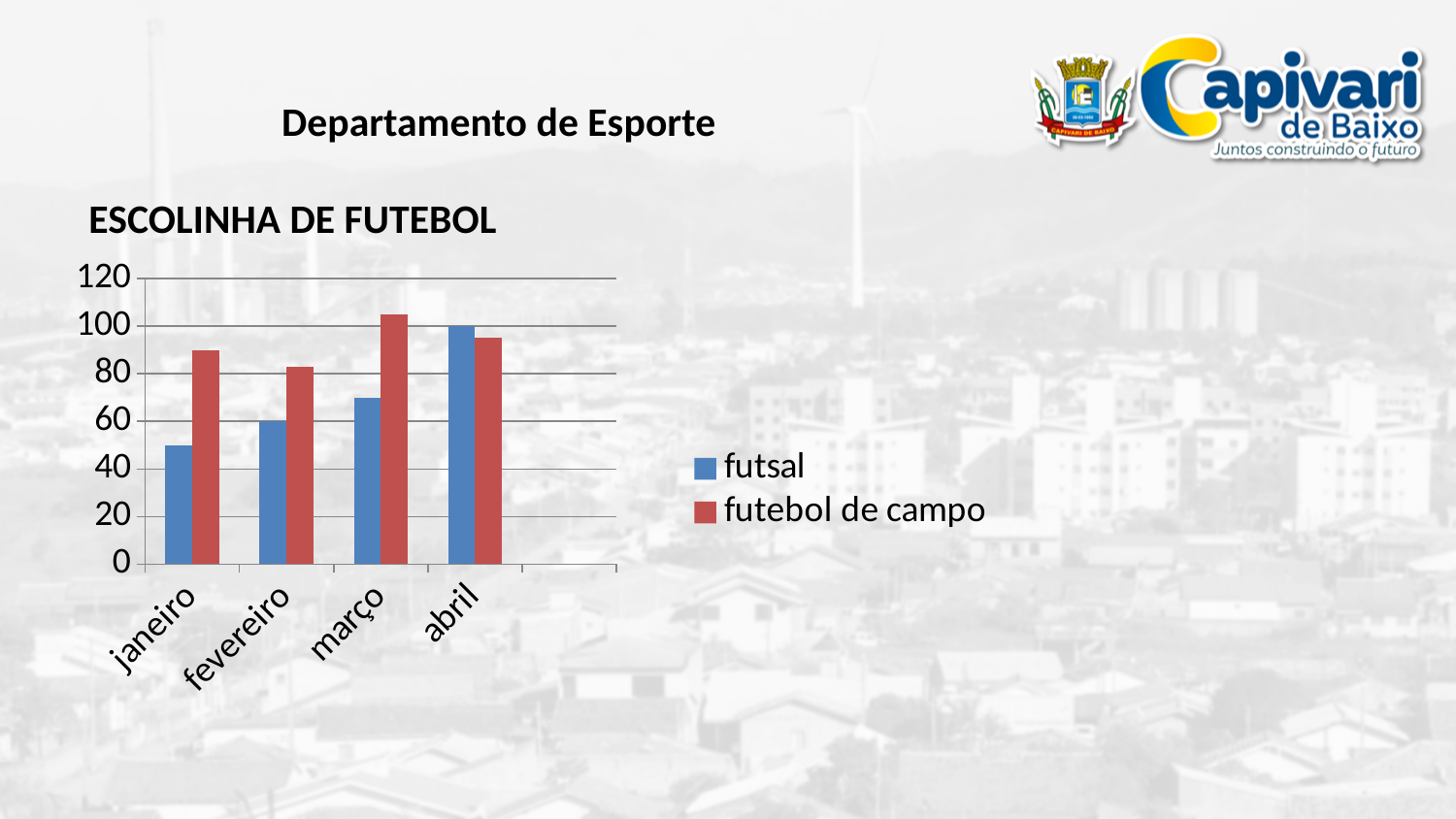
In janeiro, which series has the larger value, futsal or futebol de campo? futebol de campo What is the futsal value for fevereiro? 60 Is the futebol de campo value for março greater or less than 100? greater How many months are shown on the x axis of the ESCOLINHA DE FUTEBOL chart? 4 In which month is the futebol de campo value highest? março How many series does the legend of the ESCOLINHA DE FUTEBOL chart list? 2 In which month is the futsal value highest? abril In which month is the futsal value lowest? janeiro Do the futsal values rise or fall from janeiro to abril? rise What is the futsal value for abril? 100 Is the futsal value for janeiro greater or less than 40? greater What kind of chart is shown under the title ESCOLINHA DE FUTEBOL? bar chart